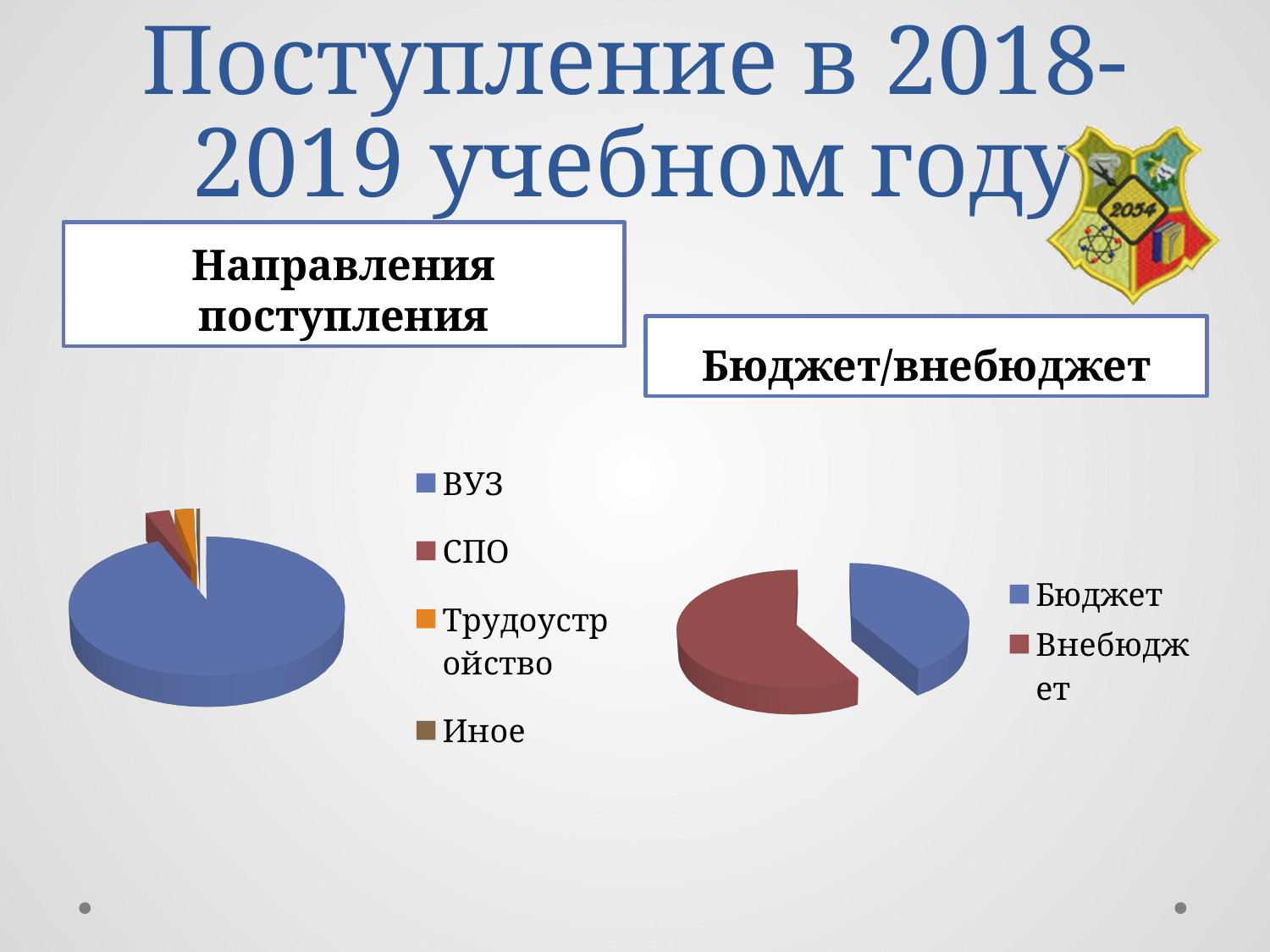
In the "Бюджет/внебюджет" chart, how many categories does the legend list? 2 In the "Направления поступления" chart, what colour is the ВУЗ slice? blue In the "Бюджет/внебюджет" chart, which category has the largest slice? Внебюджет In the "Бюджет/внебюджет" chart, which slice is larger, Бюджет or Внебюджет? Внебюджет What kind of chart is the "Направления поступления" chart on the left? pie chart In the "Бюджет/внебюджет" chart, which category has the smallest slice? Бюджет In the "Направления поступления" chart, which slice is larger, ВУЗ or СПО? ВУЗ In the "Направления поступления" chart, which category has the largest slice? ВУЗ In the "Направления поступления" chart, how many categories does the legend list? 4 In the "Бюджет/внебюджет" chart, what colour is the Внебюджет slice? red What kind of chart is the "Бюджет/внебюджет" chart on the right? pie chart